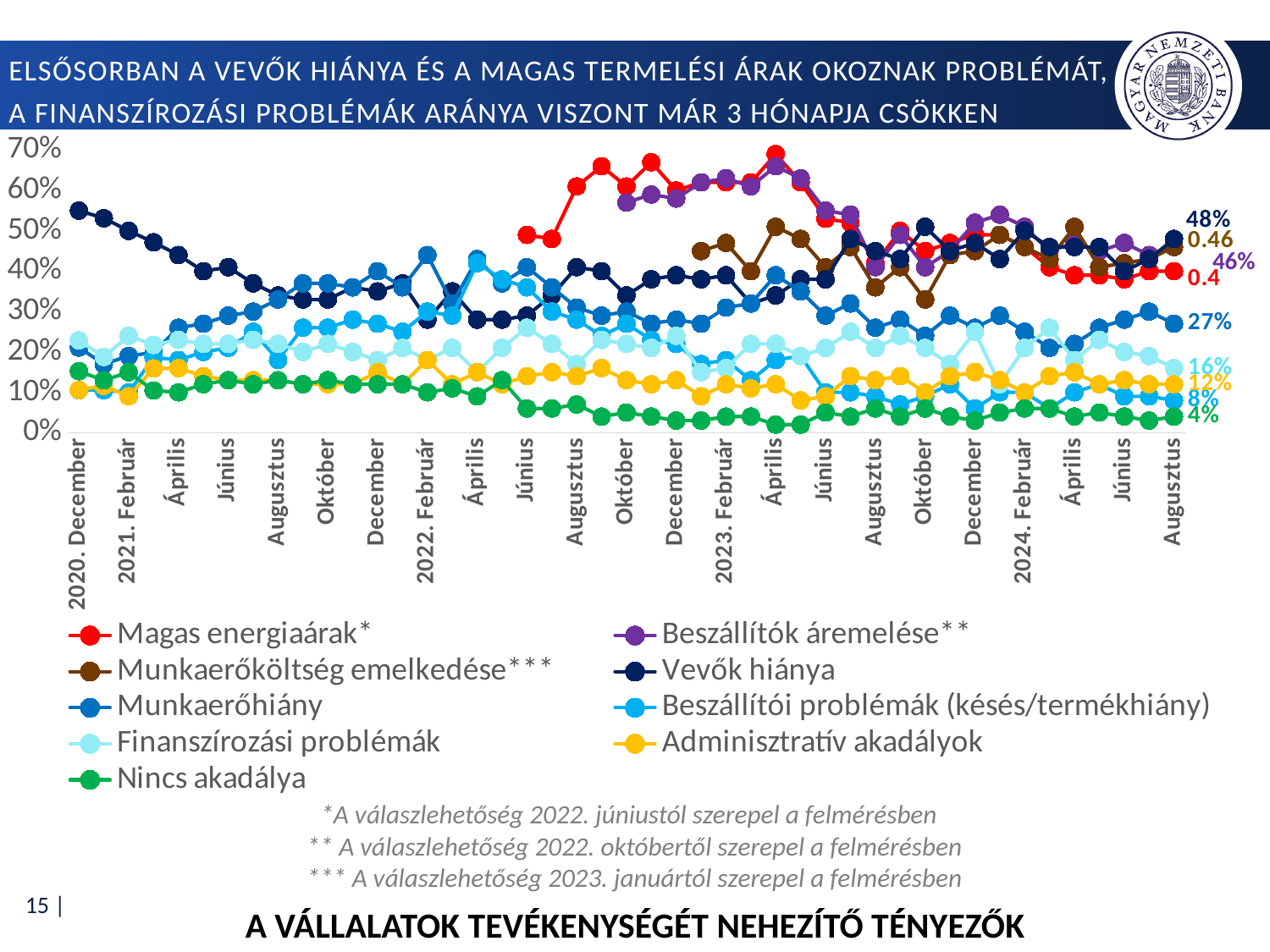
At the last point (2024 Augusztus), what is the difference between Vevők hiánya and Munkaerőhiány? 21 percentage points What is the value for Munkaerőhiány at the last point (2024 Augusztus)? 27% How many series does the legend list? 9 Is the value for Vevők hiánya in 2020 December greater or less than 50%? greater Which series has the lowest value at the last point (2024 Augusztus)? Nincs akadálya At the last point (2024 Augusztus), which is larger: Munkaerőhiány or Adminisztratív akadályok? Munkaerőhiány Which series has the highest value at the last point (2024 Augusztus)? Vevők hiánya What is the value for Finanszírozási problémák at the last point (2024 Augusztus)? 16% What is the value for Vevők hiánya at the last point (2024 Augusztus)? 48% What is the value for Beszállítók áremelése at the last point (2024 Augusztus)? 46% What is the value for Nincs akadálya at the last point (2024 Augusztus)? 4% What kind of chart is shown on the slide? line chart